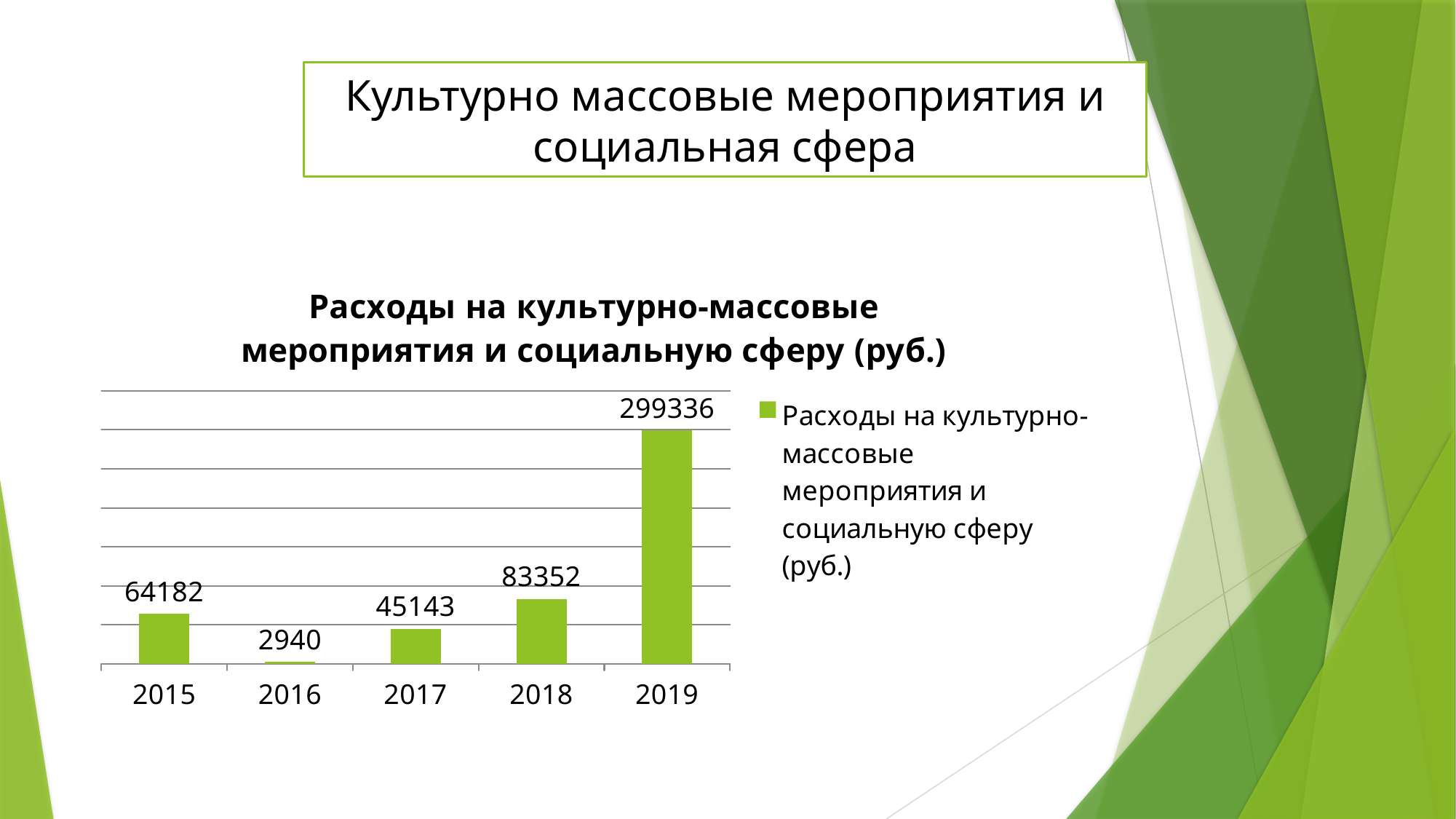
What is the difference between the values for 2015 and 2016? 61242 What is the value for 2019 in the chart? 299336 Which year has the highest value in the chart? 2019 What is the value for 2015 in the chart? 64182 Which is larger, the value for 2015 or the value for 2017? 2015 What kind of chart is shown on the slide? bar chart What is the value for 2016 in the chart? 2940 What is the difference between the values for 2019 and 2018? 215984 Which year has the lowest value in the chart? 2016 What is the value for 2017 in the chart? 45143 How many years are shown on the x axis of the chart? 5 How many series does the chart legend list? 1